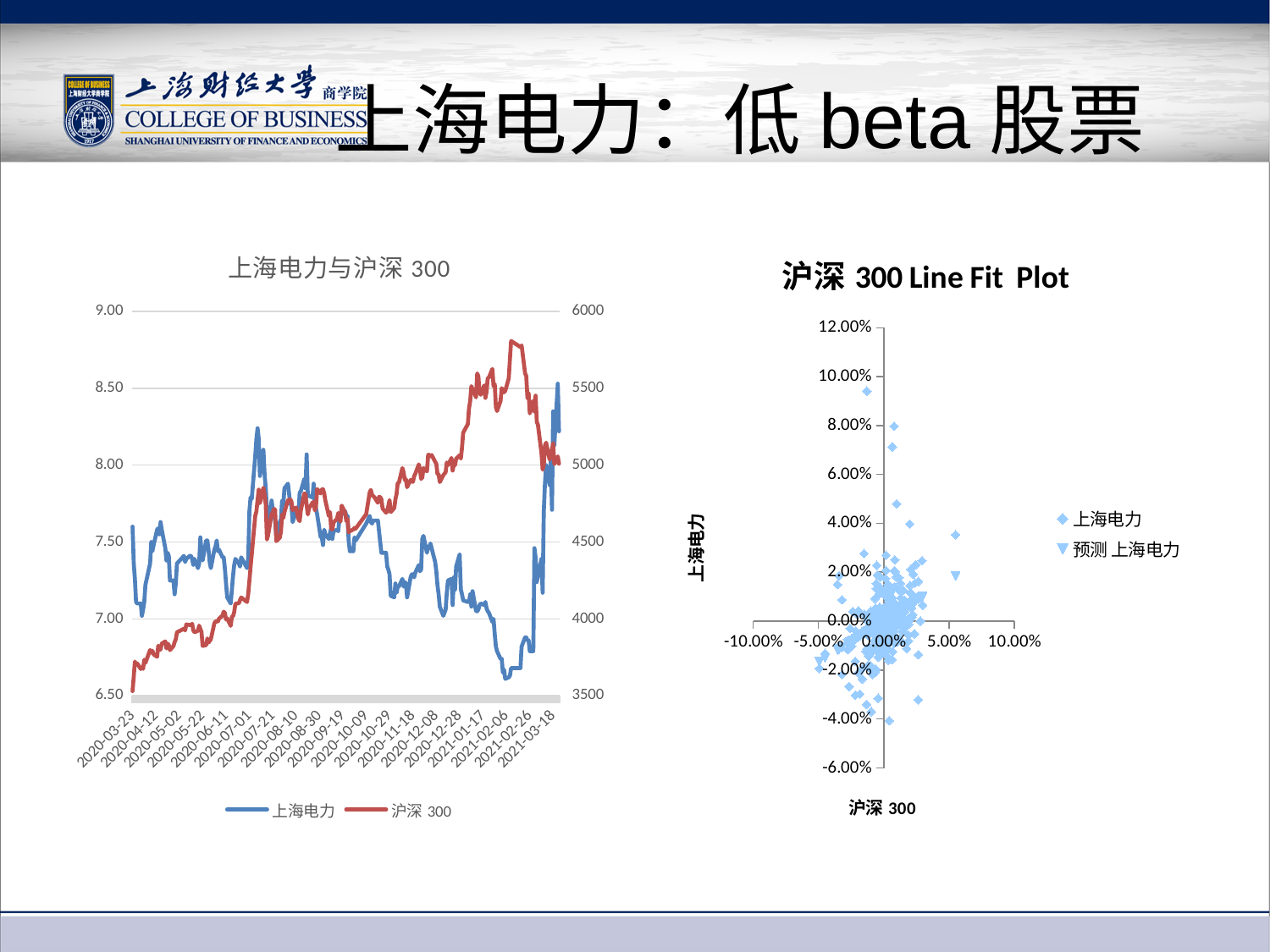
In the chart titled "上海电力与沪深 300", is the value of 沪深 300 at 2020-03-23 greater or less than 4000? less In the chart titled "沪深 300 Line Fit Plot", is the lowest plotted 上海电力 value greater or less than -2.00%? less In the chart titled "上海电力与沪深 300", is the lowest value of 上海电力 in February 2021 greater or less than 7.00? less In the chart titled "上海电力与沪深 300", which series is drawn in red? 沪深 300 What kind of chart is the chart titled "上海电力与沪深 300"? line chart What is the label of the vertical axis in the chart titled "沪深 300 Line Fit Plot"? 上海电力 How many series does the legend of the chart titled "上海电力与沪深 300" list? 2 In the chart titled "上海电力与沪深 300", does the 沪深 300 series overall rise or fall from 2020-03-23 to 2021-03-18? rise What kind of chart is the chart titled "沪深 300 Line Fit Plot"? scatter plot How many series does the legend of the chart titled "沪深 300 Line Fit Plot" list? 2